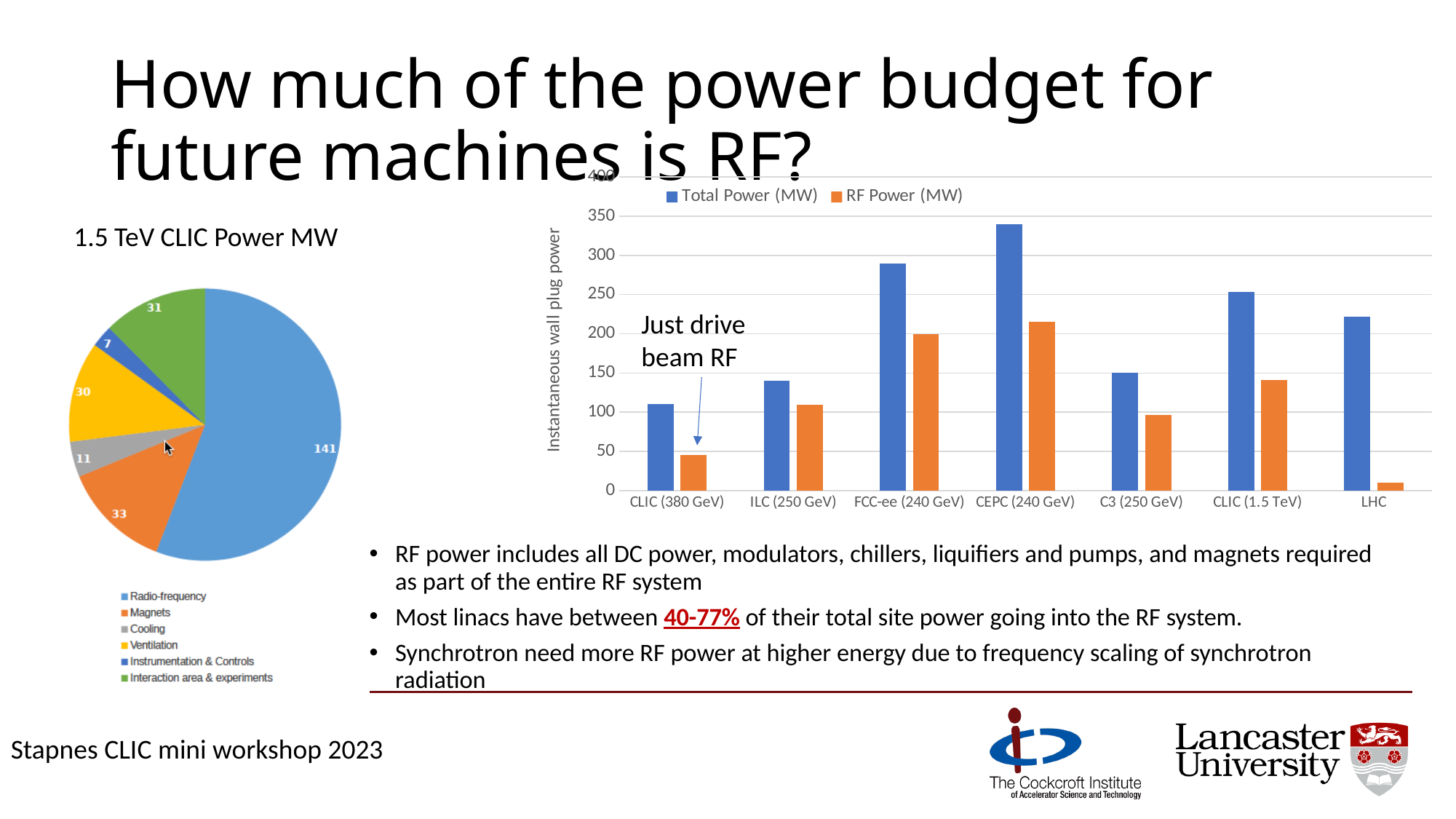
On the pie chart titled '1.5 TeV CLIC Power MW', how many categories does the legend list? 6 On the bar chart on the right, is the Total Power (MW) for CEPC (240 GeV) greater or less than 300? greater On the pie chart titled '1.5 TeV CLIC Power MW', what is the value for Instrumentation & Controls? 7 On the bar chart on the right, which is larger: the Total Power (MW) for FCC-ee (240 GeV) or for ILC (250 GeV)? FCC-ee (240 GeV) On the bar chart on the right, which machine has the highest Total Power (MW)? CEPC (240 GeV) On the bar chart on the right, how many series does the legend list? 2 On the bar chart on the right, which machine has the lowest RF Power (MW)? LHC On the pie chart titled '1.5 TeV CLIC Power MW', what is the value for Radio-frequency? 141 On the pie chart titled '1.5 TeV CLIC Power MW', what is the value for Magnets? 33 On the bar chart on the right, is the RF Power (MW) for CLIC (380 GeV) greater or less than 50? less On the pie chart titled '1.5 TeV CLIC Power MW', what is the difference between the Radio-frequency value and the Magnets value? 108 On the pie chart titled '1.5 TeV CLIC Power MW', which category has the smallest slice? Instrumentation & Controls